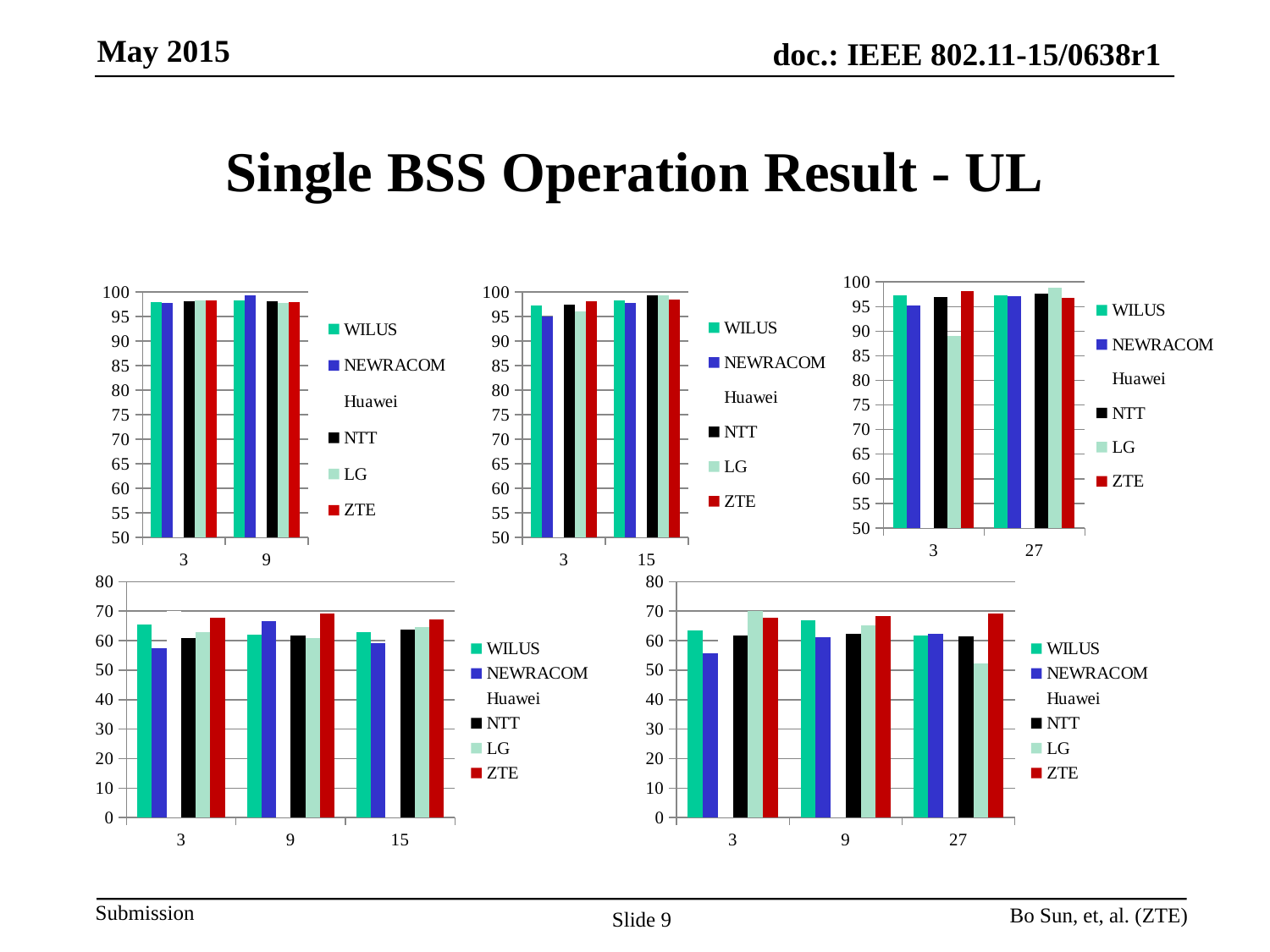
In the bottom-right chart, which series has the highest value at category 27? ZTE In the top-right chart, which series has the lowest value at category 3? LG How many categories are shown on the x axis of the bottom-right chart? 3 In the bottom-right chart at category 3, which is larger: LG or NEWRACOM? LG In the top-right chart, is the value for LG at category 3 greater or less than 95? less What kind of chart is the bottom-left chart? bar chart In the bottom-left chart, is the value for NEWRACOM at category 3 greater or less than 60? less How many categories are shown on the x axis of the top-left chart? 2 How many series does the legend of the top-right chart list? 6 In the bottom-right chart, which series has the lowest value at category 3? NEWRACOM In the bottom-right chart, is the value for LG at category 27 greater or less than 60? less What are the x-axis category labels of the top-middle chart? 3 and 15